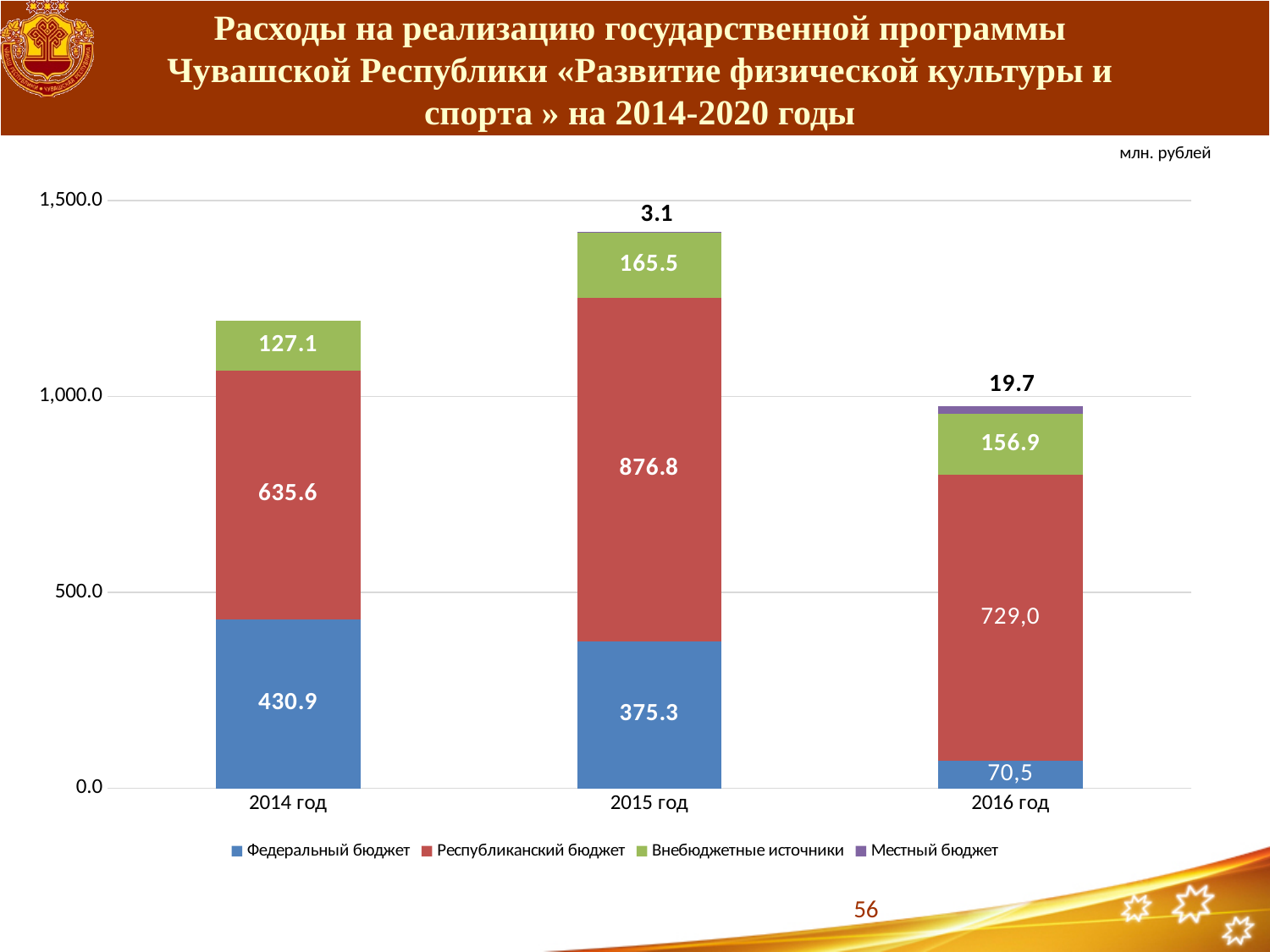
What is the difference between the Федеральный бюджет values for 2014 год and 2015 год? 55.6 What is the total of the stacked bar for 2015 год? 1420.7 What is the value of Местный бюджет for 2016 год? 19.7 Which year has the lowest value for Федеральный бюджет? 2016 год What is the value of Федеральный бюджет for 2014 год? 430.9 Is the total of the stacked bar for 2016 год greater or less than 1,000.0? less How many series does the legend list? 4 How many years (categories) are shown on the x axis? 3 Which year has the highest value for Республиканский бюджет? 2015 год What is the value of Внебюджетные источники for 2016 год? 156.9 What is the value of Республиканский бюджет for 2015 год? 876.8 What type of chart is shown on the slide? stacked bar chart